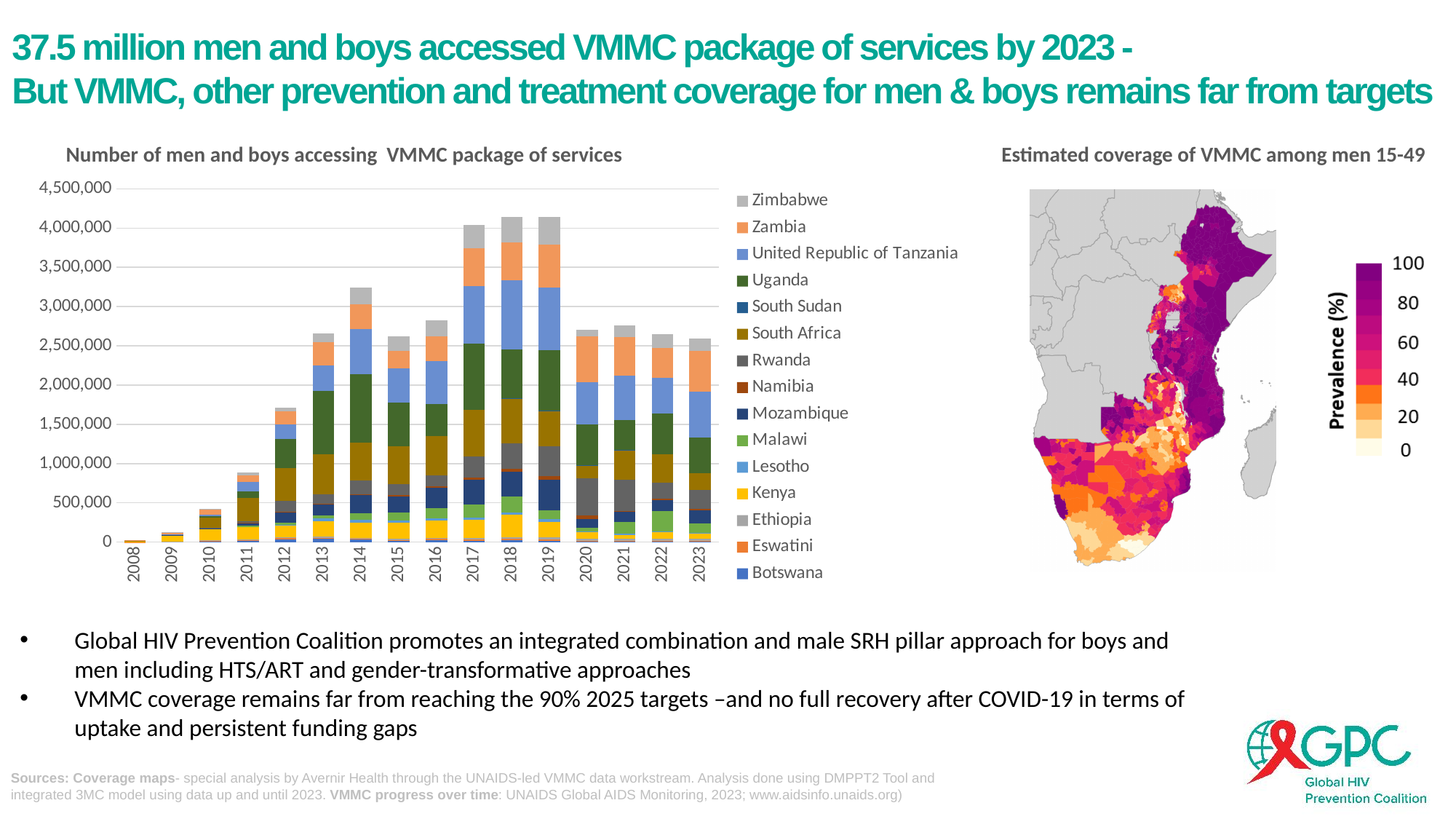
In the 'Number of men and boys accessing VMMC package of services' chart, which year has the larger total, 2013 or 2017? 2017 What kind of chart is the 'Number of men and boys accessing VMMC package of services' chart? Stacked bar chart In the 'Number of men and boys accessing VMMC package of services' chart, which year has the lowest total? 2008 In the 'Number of men and boys accessing VMMC package of services' chart, is the total for 2014 greater or less than 3,000,000? greater In the 'Number of men and boys accessing VMMC package of services' chart, is the total for 2020 greater or less than 3,000,000? less How many countries does the legend of the 'Number of men and boys accessing VMMC package of services' chart list? 15 What is the title of the map on the right of the slide? Estimated coverage of VMMC among men 15-49 In the 'Number of men and boys accessing VMMC package of services' chart, does the total rise or fall from 2019 to 2020? Fall In the 'Number of men and boys accessing VMMC package of services' chart, is the total for 2011 greater or less than 1,000,000? less How many years are shown on the x axis of the 'Number of men and boys accessing VMMC package of services' chart? 16 In the 'Number of men and boys accessing VMMC package of services' chart, do the totals rise or fall from 2008 to 2014? Rise